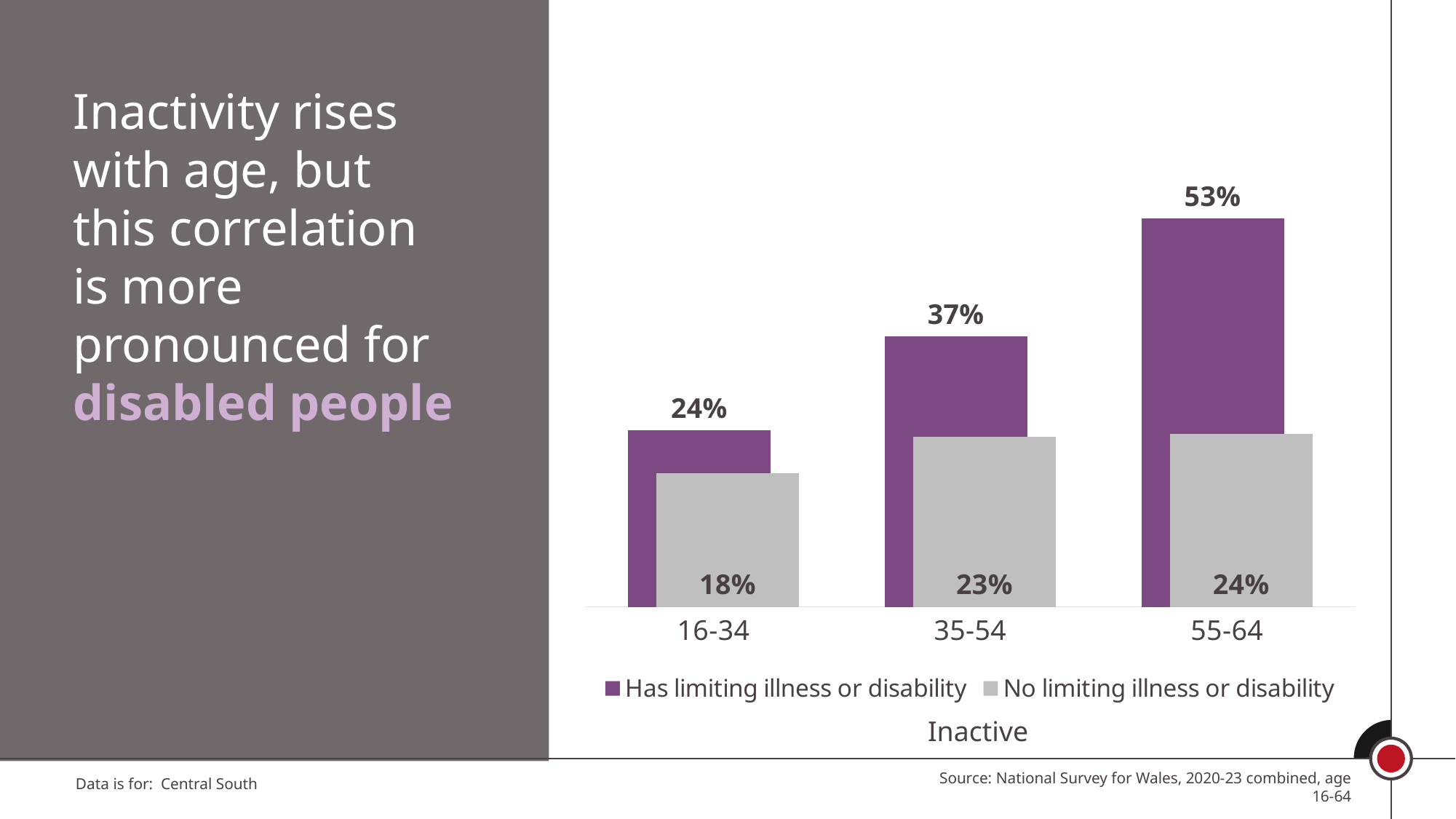
What is the inactivity rate for people aged 16-34 with no limiting illness or disability? 18% In the 35-54 age group, which is larger: the value for people with a limiting illness or disability, or the value for people without? Has limiting illness or disability Which age group has the highest inactivity rate among people with a limiting illness or disability? 55-64 What is the difference between the inactivity rates of people with and without a limiting illness or disability in the 55-64 age group? 29% What is the difference between the 'Has limiting illness or disability' values for the 55-64 and 16-34 age groups? 29% What is the inactivity rate for people aged 55-64 who have a limiting illness or disability? 53% How many age groups are shown on the x axis of the chart? 3 What type of chart is shown on the slide? Bar chart Which age group has the lowest inactivity rate among people with no limiting illness or disability? 16-34 How many series does the chart legend list? 2 What is the value for the 35-54 age group in the 'Has limiting illness or disability' series? 37% What is the value for the 55-64 age group in the 'No limiting illness or disability' series? 24%